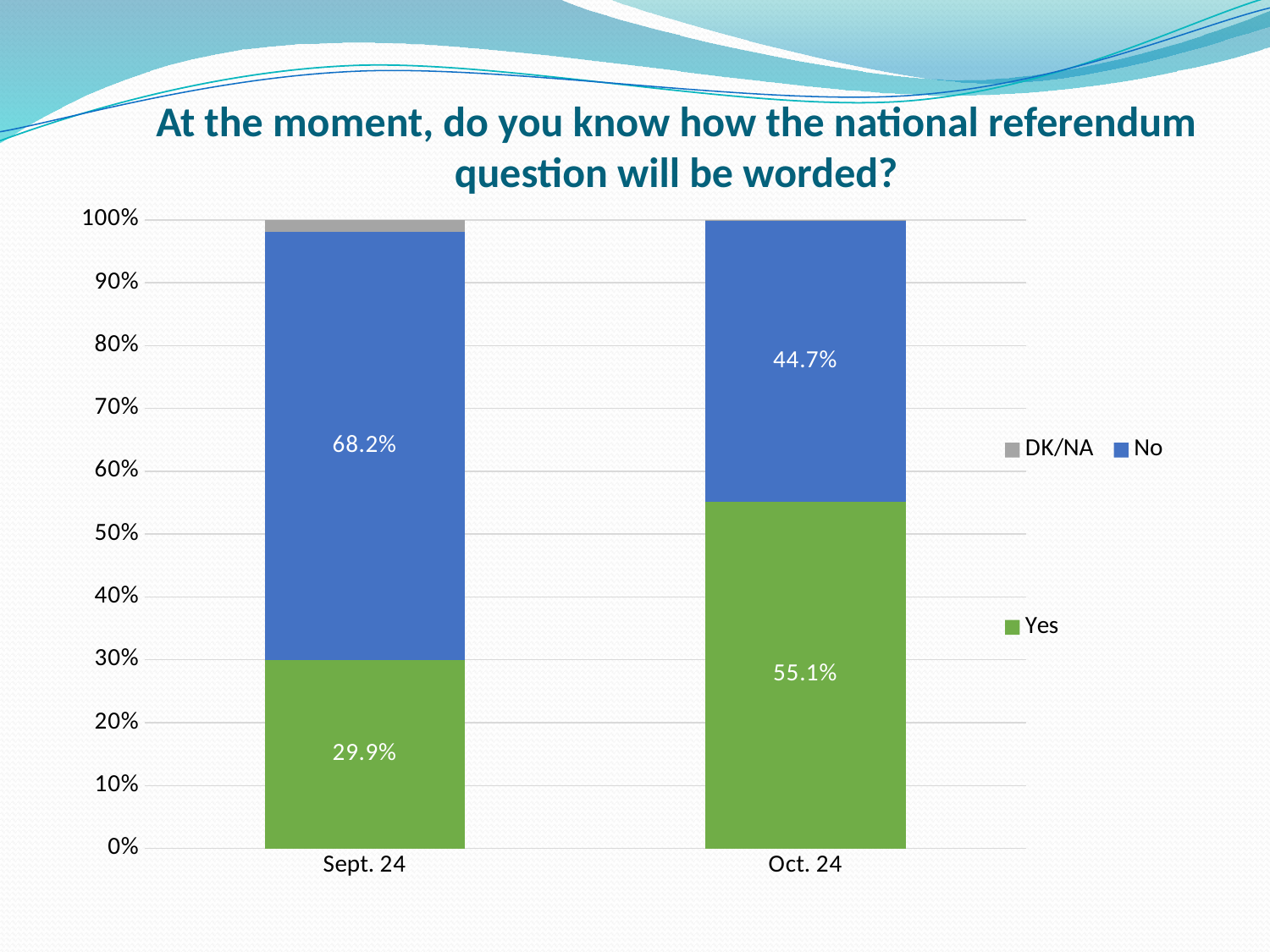
What is the value of the Yes segment for Oct. 24? 55.1% Is the DK/NA value for Sept. 24 greater or less than 10%? less How many series does the legend list? 3 What percentage answered No in Oct. 24? 44.7% Which category has the higher Yes value, Sept. 24 or Oct. 24? Oct. 24 What is the value of the No segment for Sept. 24? 68.2% By how many percentage points did the Yes value increase from Sept. 24 to Oct. 24? 25.2 percentage points Which category has the higher No value, Sept. 24 or Oct. 24? Sept. 24 Does the Yes value rise or fall from Sept. 24 to Oct. 24? Rise How many categories are shown on the x axis? 2 What kind of chart is shown on the slide? Stacked bar chart What percentage answered Yes in Sept. 24? 29.9%